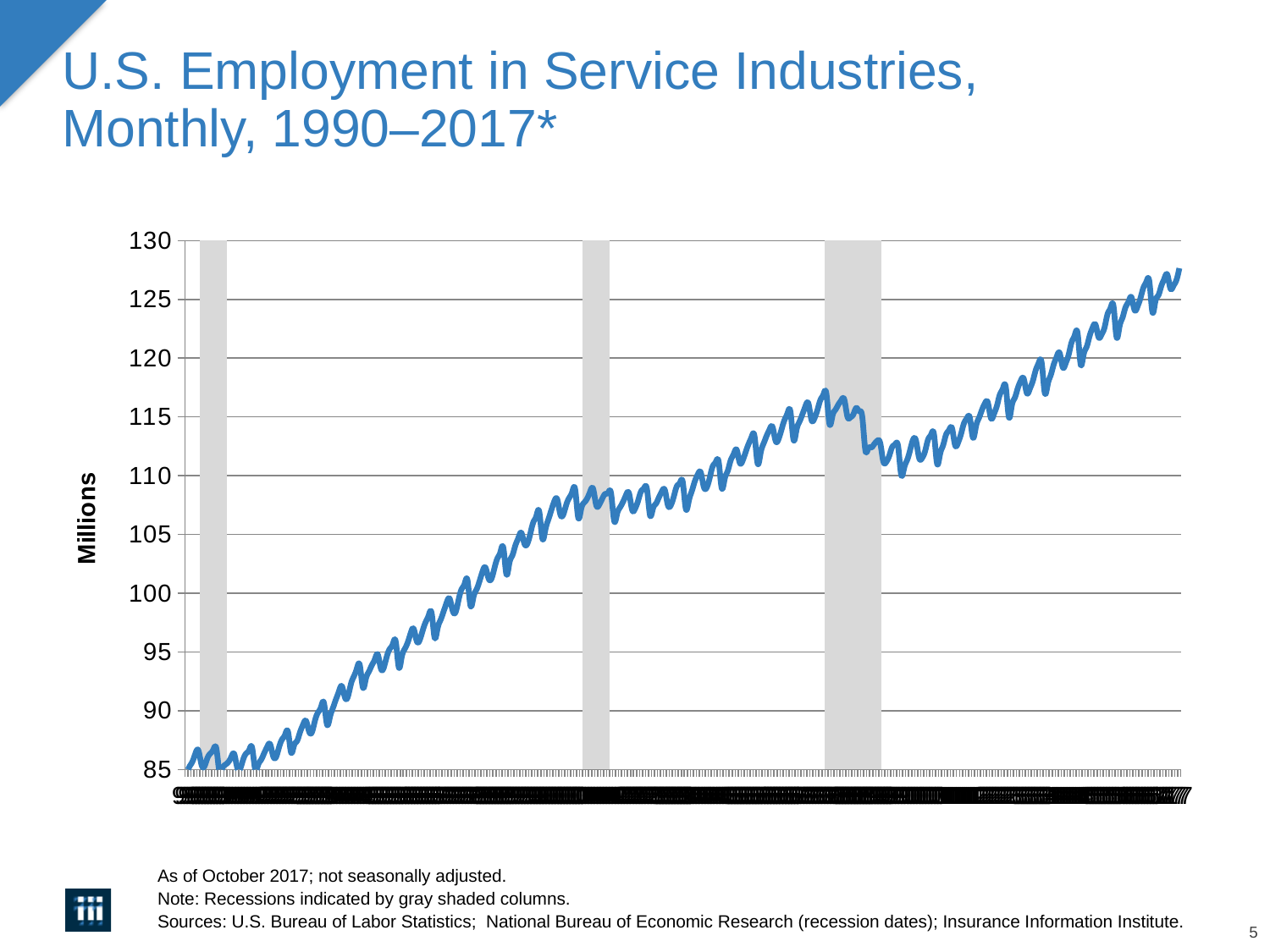
Is the value at the end of the series (2017) greater or less than 125? greater Is the value at the start of the series (1990) greater or less than 90? less What is the title of the chart? U.S. Employment in Service Industries, Monthly, 1990–2017* What kind of chart is shown on the slide? line chart Is the value at the end of the series (2017) greater or less than 130? less What is the lowest value shown on the vertical axis? 85 How many gray shaded recession columns are shown on the chart? 3 What is the highest value shown on the vertical axis? 130 Overall, do the values rise or fall from 1990 to 2017 along the x axis? rise